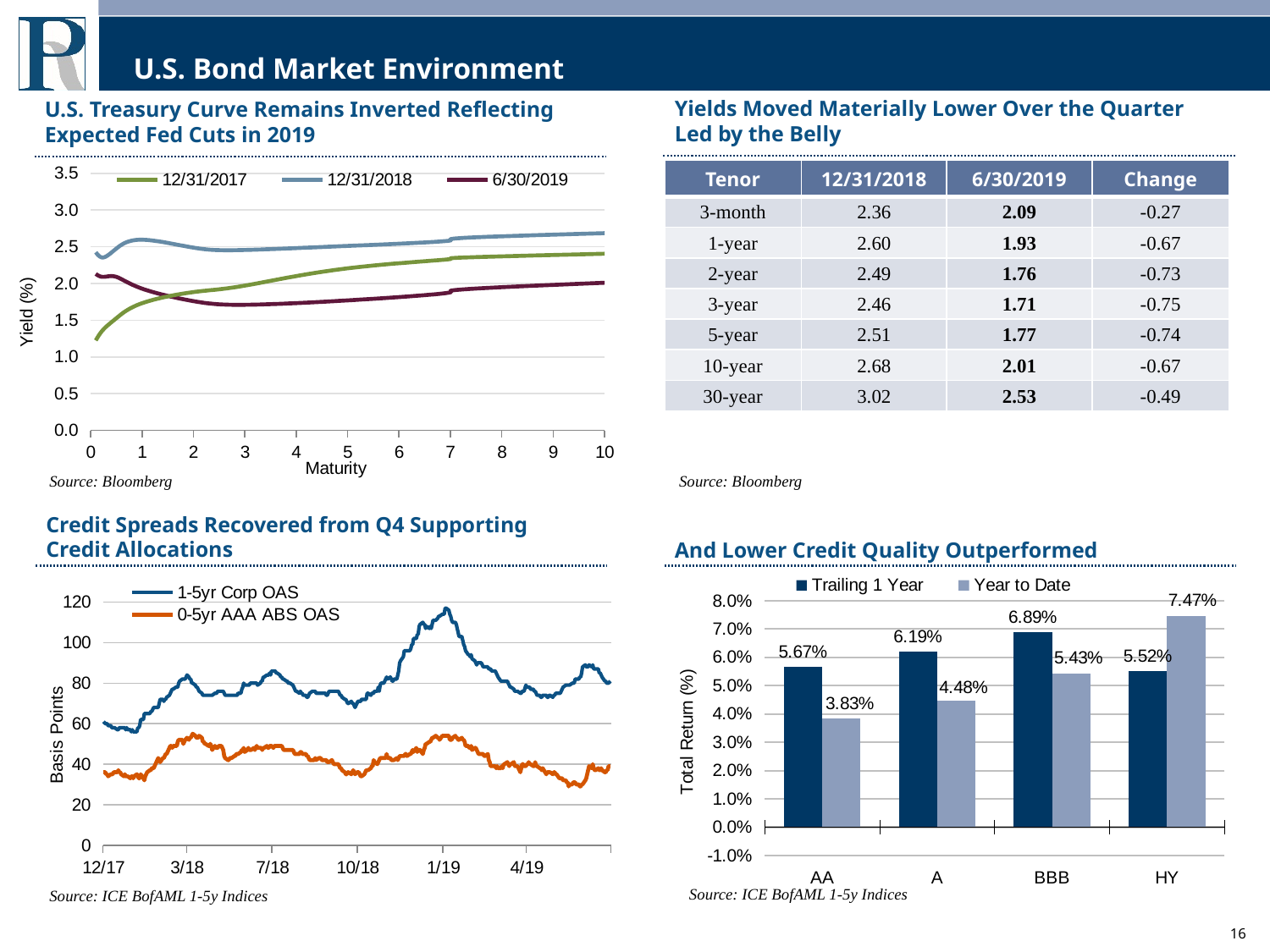
In the 'Credit Spreads Recovered from Q4' chart, is the peak value of the 1-5yr Corp OAS series around 1/19 greater or less than 100 basis points? greater In the 'And Lower Credit Quality Outperformed' chart, what is the Year to Date total return for HY? 7.47% What kind of chart is the 'And Lower Credit Quality Outperformed' chart? bar chart How many series does the legend of the 'U.S. Treasury Curve Remains Inverted' chart list? 3 In the 'And Lower Credit Quality Outperformed' chart, which category has the highest Trailing 1 Year total return? BBB In the 'And Lower Credit Quality Outperformed' chart, which category has the lowest Year to Date total return? AA In the 'And Lower Credit Quality Outperformed' chart, what is the Trailing 1 Year total return for BBB? 6.89% In the 'And Lower Credit Quality Outperformed' chart, what is the difference between the Trailing 1 Year and Year to Date returns for AA? 1.84% In the 'U.S. Treasury Curve Remains Inverted' chart, does the 12/31/2017 yield rise or fall as maturity increases? rise In the 'U.S. Treasury Curve Remains Inverted' chart, is the 12/31/2017 yield at maturity 0 greater or less than 1.5? less In the 'And Lower Credit Quality Outperformed' chart, is the Year to Date return for HY larger or smaller than its Trailing 1 Year return? larger How many categories are shown on the x axis of the 'And Lower Credit Quality Outperformed' chart? 4